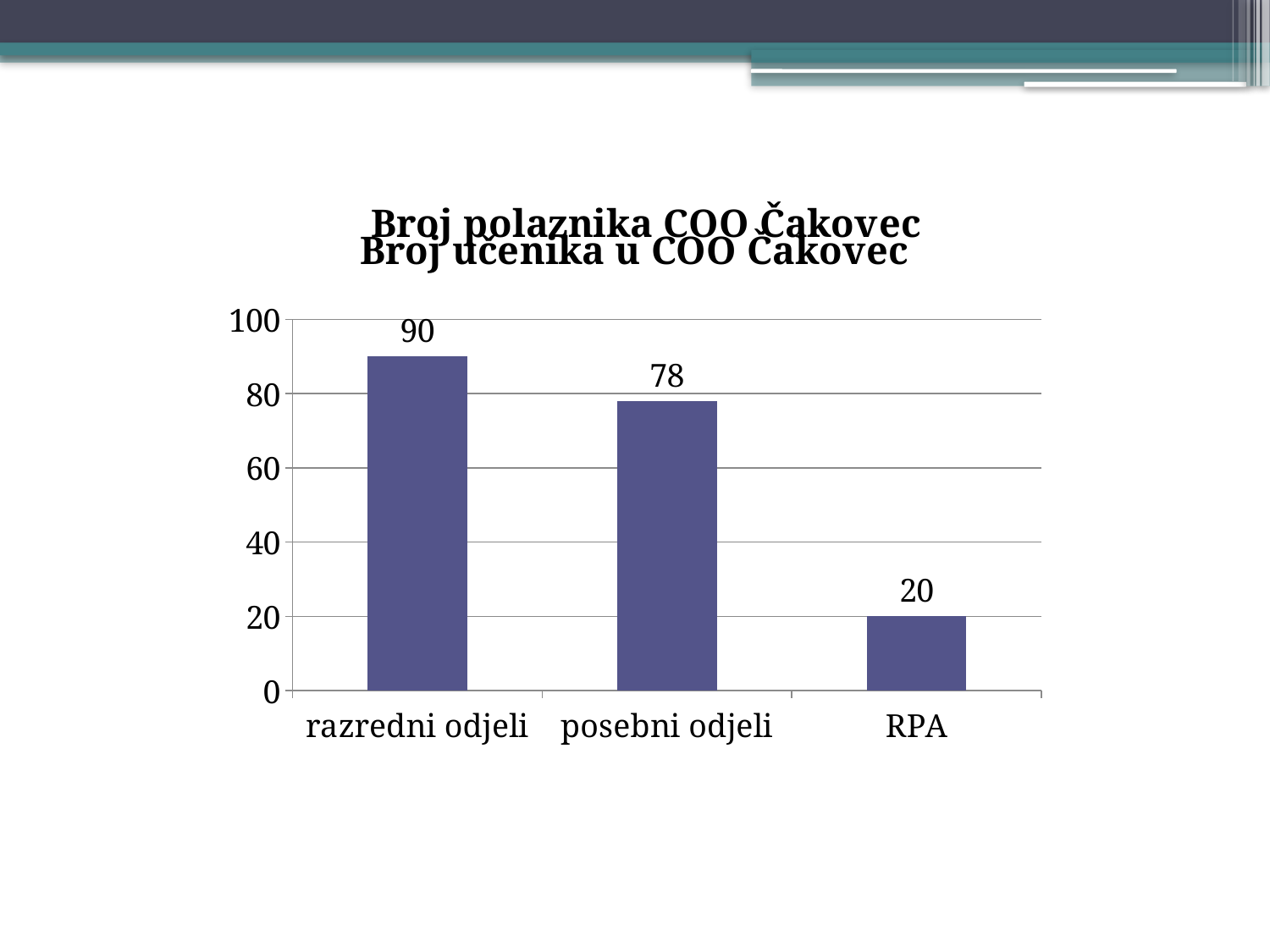
What is the value for razredni odjeli? 90 Which category has the lowest value? RPA What is the value for posebni odjeli? 78 What is the value for RPA? 20 Which category has the highest value? razredni odjeli How many categories are shown on the x axis? 3 What is the difference between the values for posebni odjeli and RPA? 58 Is the value for posebni odjeli greater or less than 60? greater What kind of chart is shown on the slide? bar chart Which is larger, the value for posebni odjeli or the value for RPA? posebni odjeli What is the difference between the values for razredni odjeli and posebni odjeli? 12 Do the values rise or fall from left to right along the x axis? fall